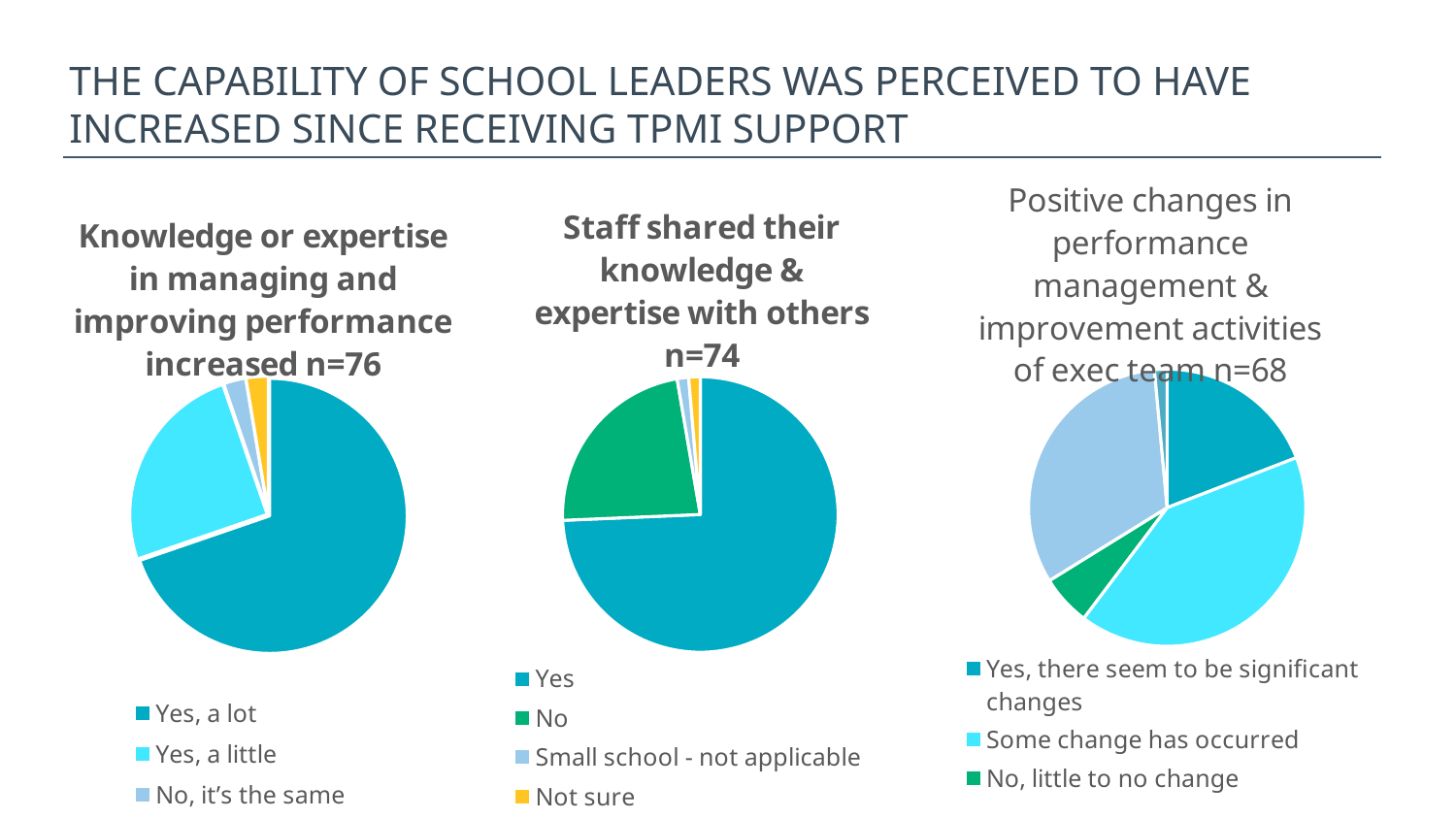
In the 'Staff shared their knowledge & expertise with others n=74' chart, what colour is the 'Not sure' slice? Yellow In the 'Knowledge or expertise in managing and improving performance increased n=76' chart, which response has the largest slice? Yes, a lot In the 'Positive changes in performance management & improvement activities of exec team n=68' chart, which slice is larger: 'Yes, there seem to be significant changes' or 'No, little to no change'? Yes, there seem to be significant changes How many pie charts are shown on the slide? 3 In the 'Staff shared their knowledge & expertise with others n=74' chart, which response has the largest slice? Yes In the 'Positive changes in performance management & improvement activities of exec team n=68' chart, which slice is larger: 'Some change has occurred' or 'No, little to no change'? Some change has occurred In the 'Knowledge or expertise in managing and improving performance increased n=76' chart, which slice is larger: 'Yes, a little' or 'No, it's the same'? Yes, a little How many entries does the legend of the 'Knowledge or expertise in managing and improving performance increased n=76' chart list? 3 What kind of chart is used for 'Knowledge or expertise in managing and improving performance increased n=76'? Pie chart What is the sample size (n) shown in the title of the chart about staff sharing their knowledge and expertise with others? n=74 How many entries does the legend of the 'Staff shared their knowledge & expertise with others n=74' chart list? 4